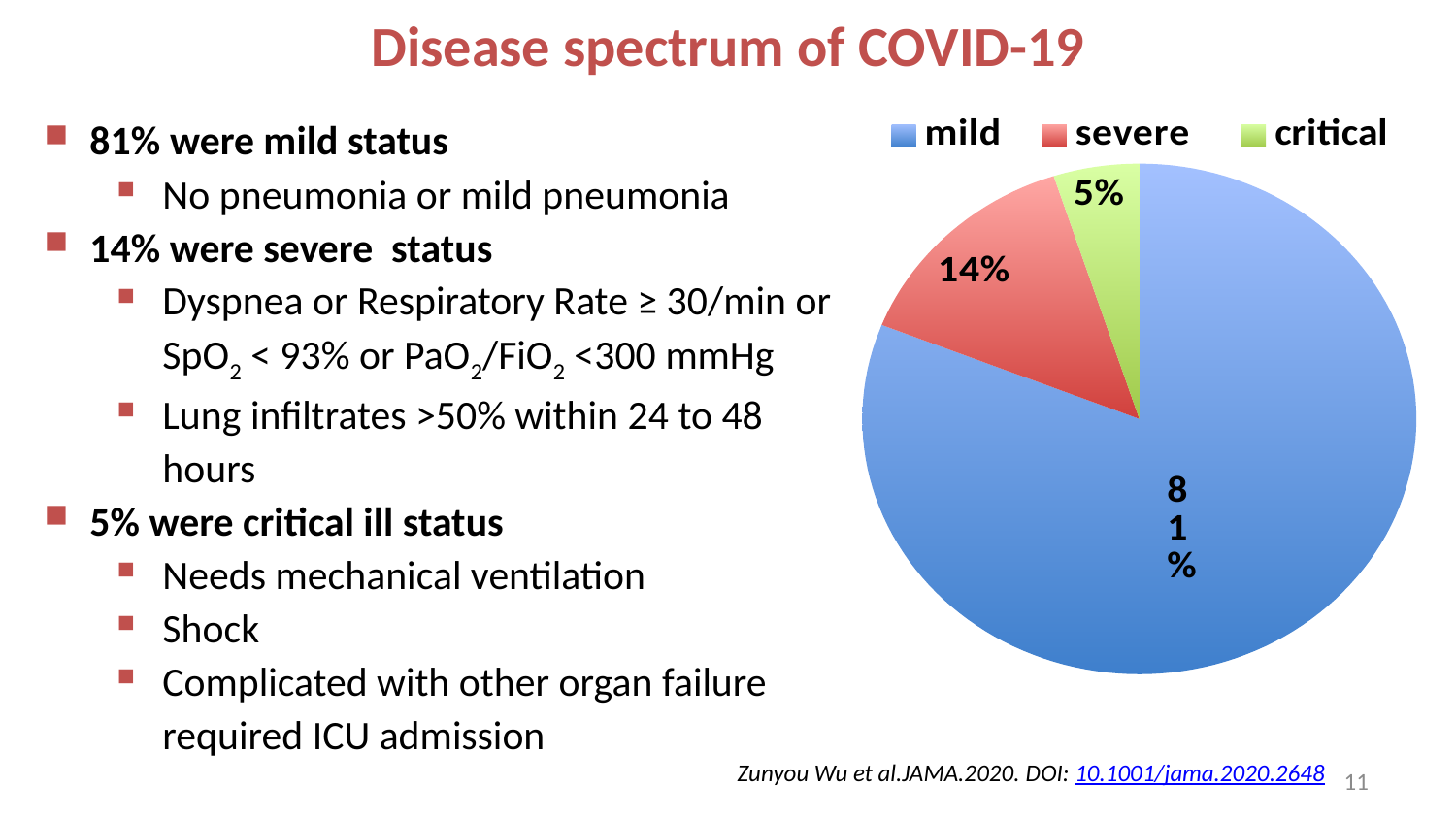
Which category has the smallest slice of the pie? critical Which category has the largest slice of the pie? mild How many entries does the legend list? 3 What share of the pie does the severe slice represent? 14% What is the difference in percentage points between the severe and critical slices? 9 What share of the pie does the critical slice represent? 5% Which slice is larger, severe or critical? severe What is the difference in percentage points between the mild and severe slices? 67 What colour is the mild slice in the pie chart? blue What kind of chart is shown on the slide? pie chart What share of the pie does the mild slice represent? 81% How many slices does the pie chart have? 3